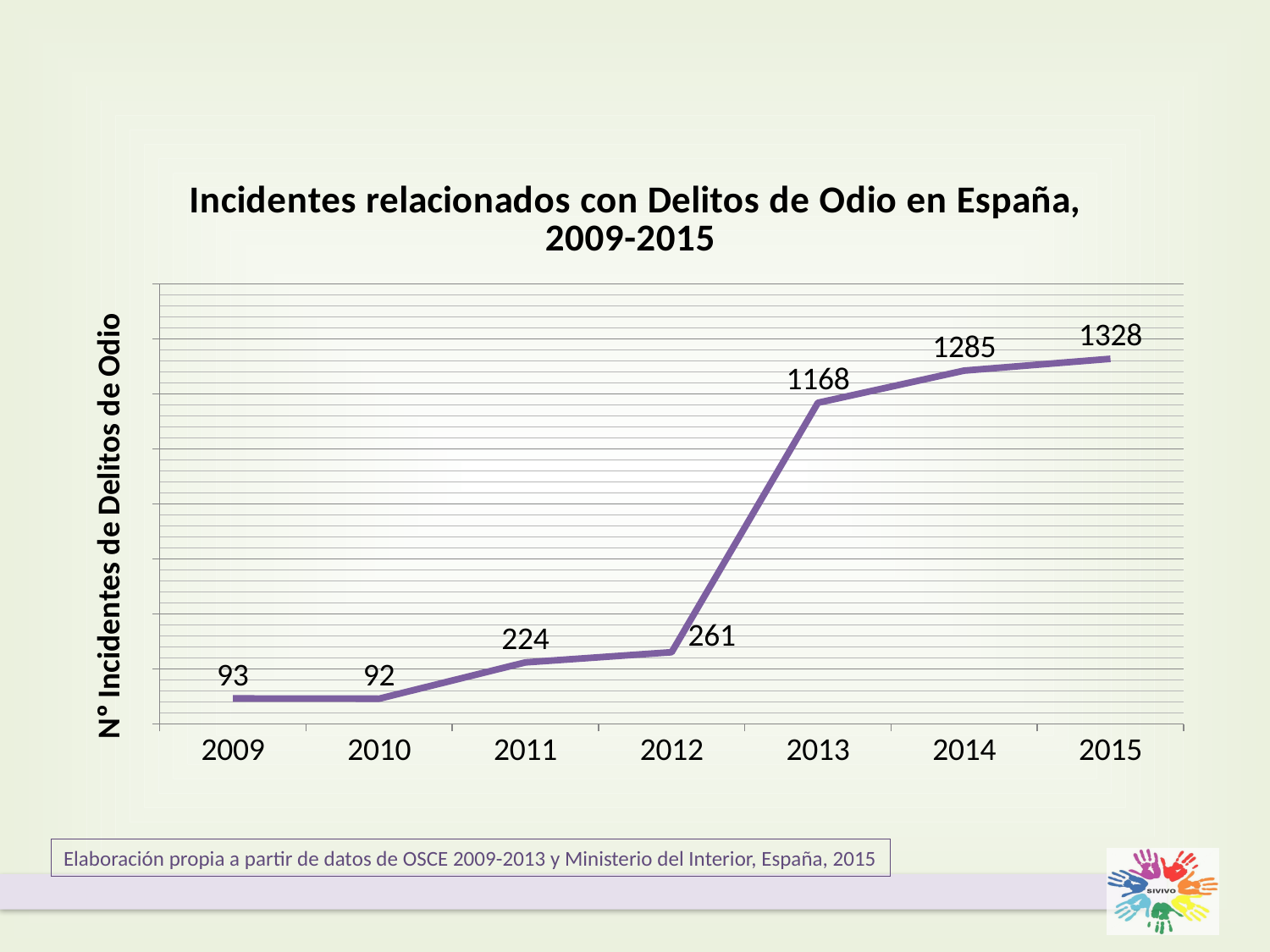
What is the difference between the values for 2013 and 2012? 907 What value is plotted for 2009? 93 What value is plotted for 2011? 224 What kind of chart is shown on the slide? line chart Which is larger, the value for 2011 or the value for 2012? 2012 How many years are plotted on the chart? 7 What is the number of hate crime incidents shown for 2013? 1168 Which year has the highest number of incidents? 2015 What is the title of the chart? Incidentes relacionados con Delitos de Odio en España, 2009-2015 Do the values generally rise or fall from 2009 to 2015? rise Which year has the lowest number of incidents? 2010 What is the difference between the values for 2015 and 2014? 43